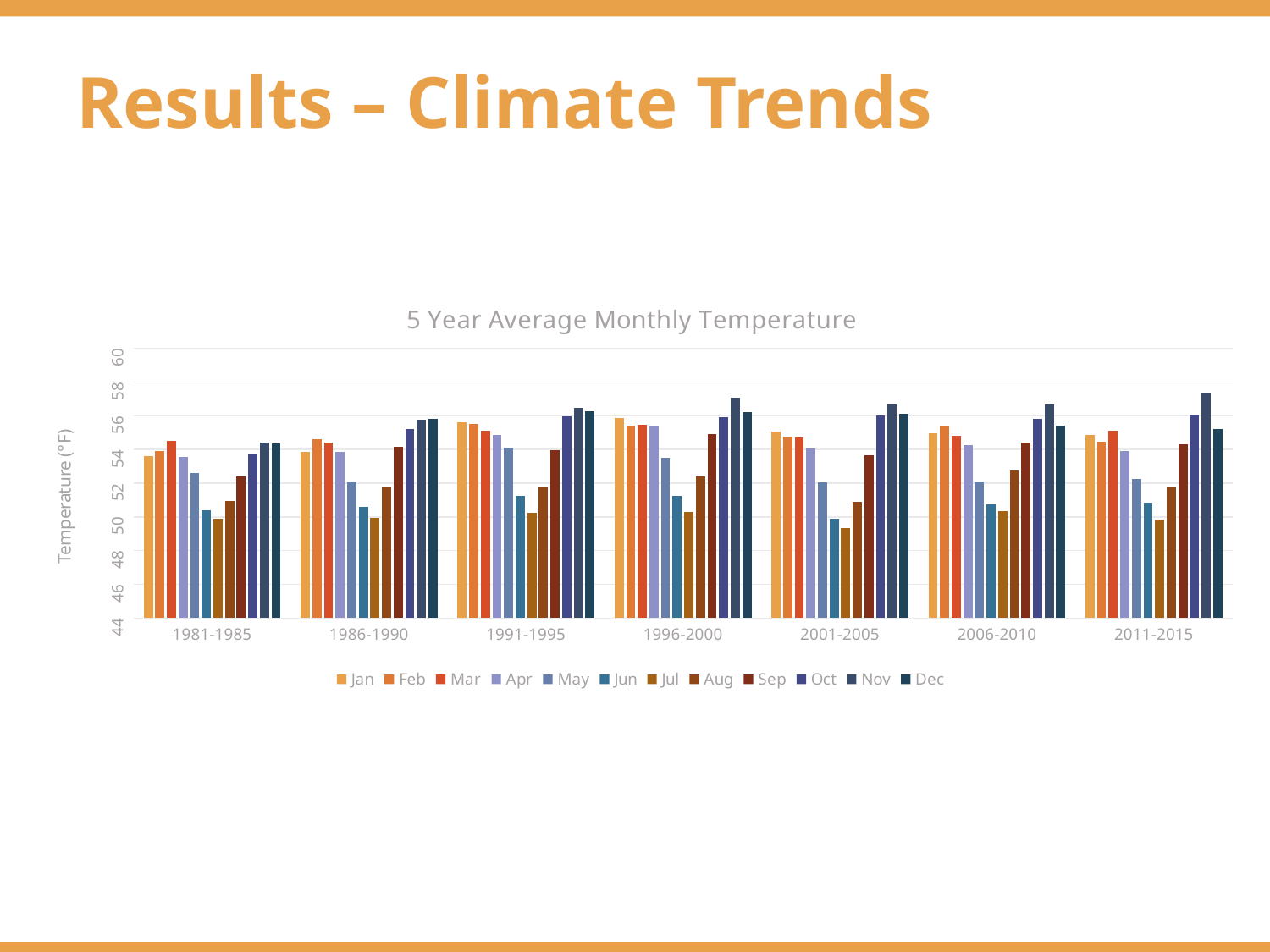
How many five-year periods are shown along the x axis? 7 Which month has the lowest value in the 1996-2000 group? Jul What type of chart is shown on the slide? bar chart Is the value for Jul in 1996-2000 greater or less than 52? less Is the value for Nov in 1996-2000 greater or less than 56? greater What is the label on the vertical axis of the chart? Temperature (°F) Which month has the highest value in the 1996-2000 group? Nov Is the value for Jan in 1991-1995 greater or less than 54? greater Which is larger, the Jan value for 1981-1985 or the Jan value for 1996-2000? 1996-2000 How many series does the legend list? 12 What is the title of the chart? 5 Year Average Monthly Temperature